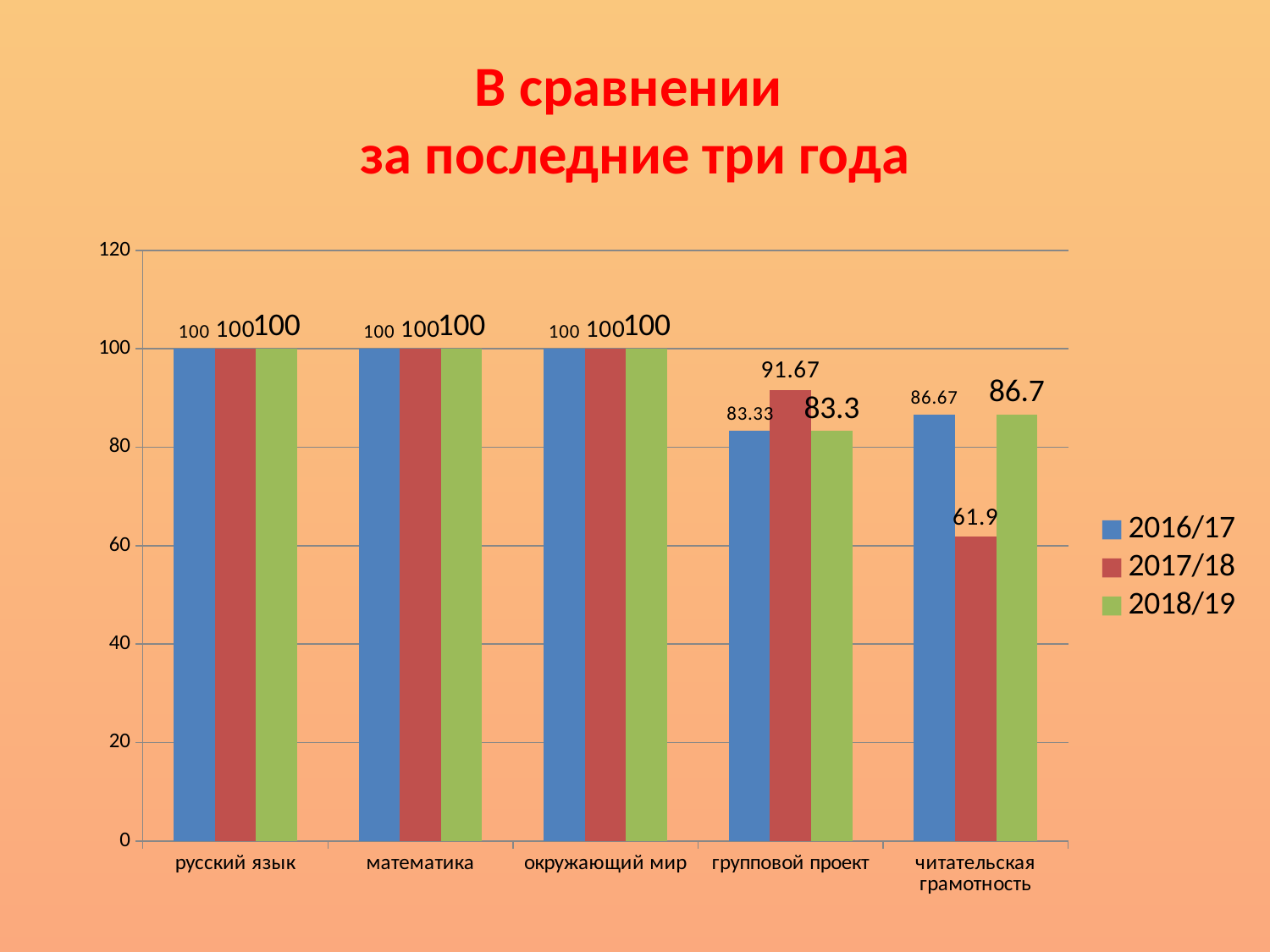
What is the value for 2017/18 in the групповой проект category? 91.67 What is the value for 2017/18 in the читательская грамотность category? 61.9 What type of chart is shown on the slide? bar chart Which series has the highest value in the групповой проект category? 2017/18 What is the value for 2016/17 in the групповой проект category? 83.33 What is the value for 2016/17 in the математика category? 100 Is the 2017/18 value for читательская грамотность greater or less than 80? less What is the value for 2018/19 in the читательская грамотность category? 86.7 What is the difference between the 2016/17 and 2017/18 values in the читательская грамотность category? 24.77 How many categories are shown on the x axis? 5 Which category has the lowest value for the 2017/18 series? читательская грамотность How many series does the legend list? 3